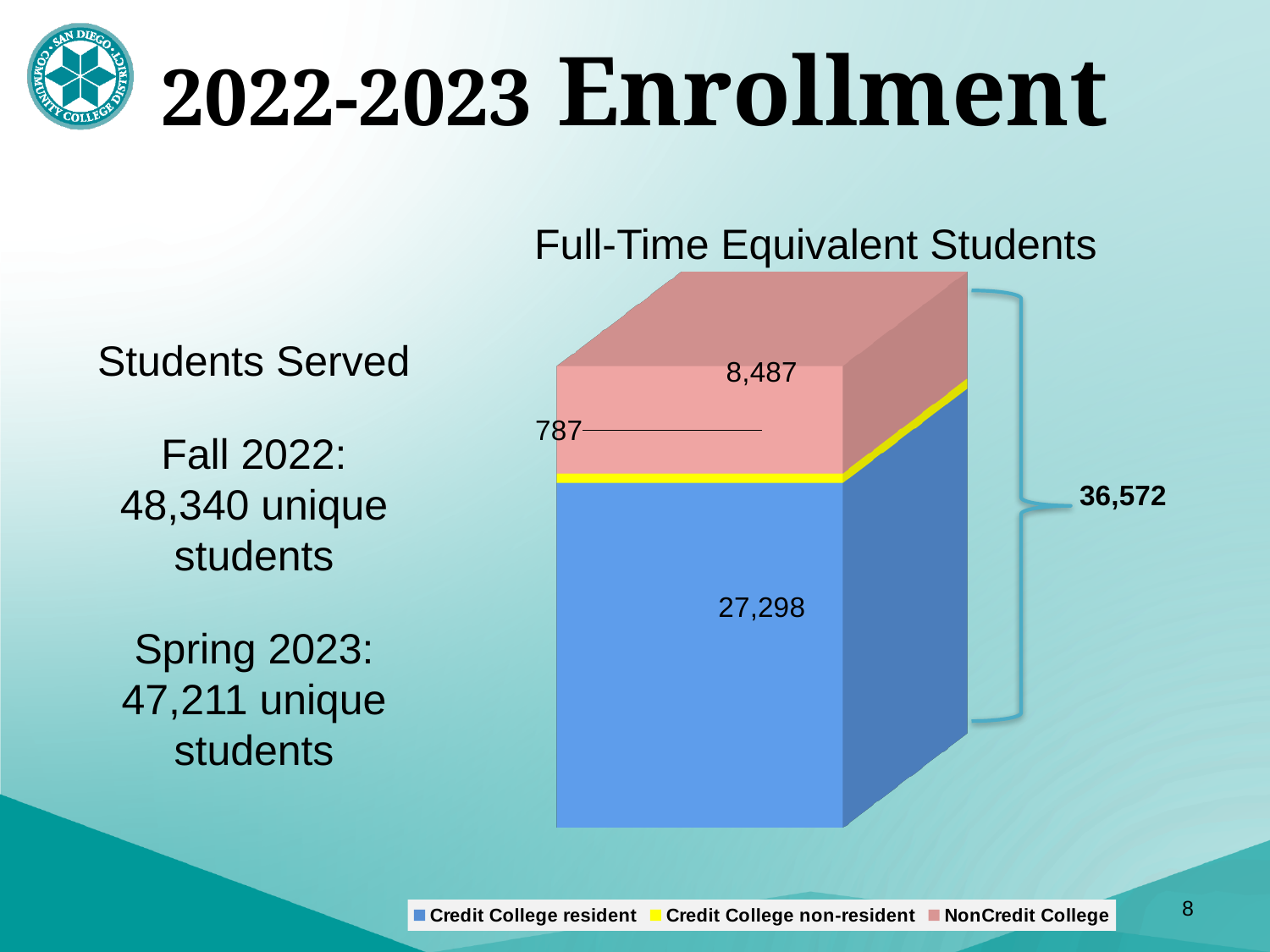
How many series does the legend list in the Full-Time Equivalent Students chart? 3 What is the value for Credit College resident in the Full-Time Equivalent Students chart? 27,298 Which series has the smallest value in the Full-Time Equivalent Students chart? Credit College non-resident What is the difference between the NonCredit College and Credit College non-resident values in the Full-Time Equivalent Students chart? 7,700 What is the value for NonCredit College in the Full-Time Equivalent Students chart? 8,487 What is the value for Credit College non-resident in the Full-Time Equivalent Students chart? 787 What colour represents Credit College non-resident in the Full-Time Equivalent Students chart? Yellow Which series has the largest value in the Full-Time Equivalent Students chart? Credit College resident What is the difference between the Credit College resident and NonCredit College values in the Full-Time Equivalent Students chart? 18,811 What is the total of the stacked bar in the Full-Time Equivalent Students chart? 36,572 What kind of chart is the Full-Time Equivalent Students chart? Stacked bar chart Which is larger in the Full-Time Equivalent Students chart: NonCredit College or Credit College non-resident? NonCredit College